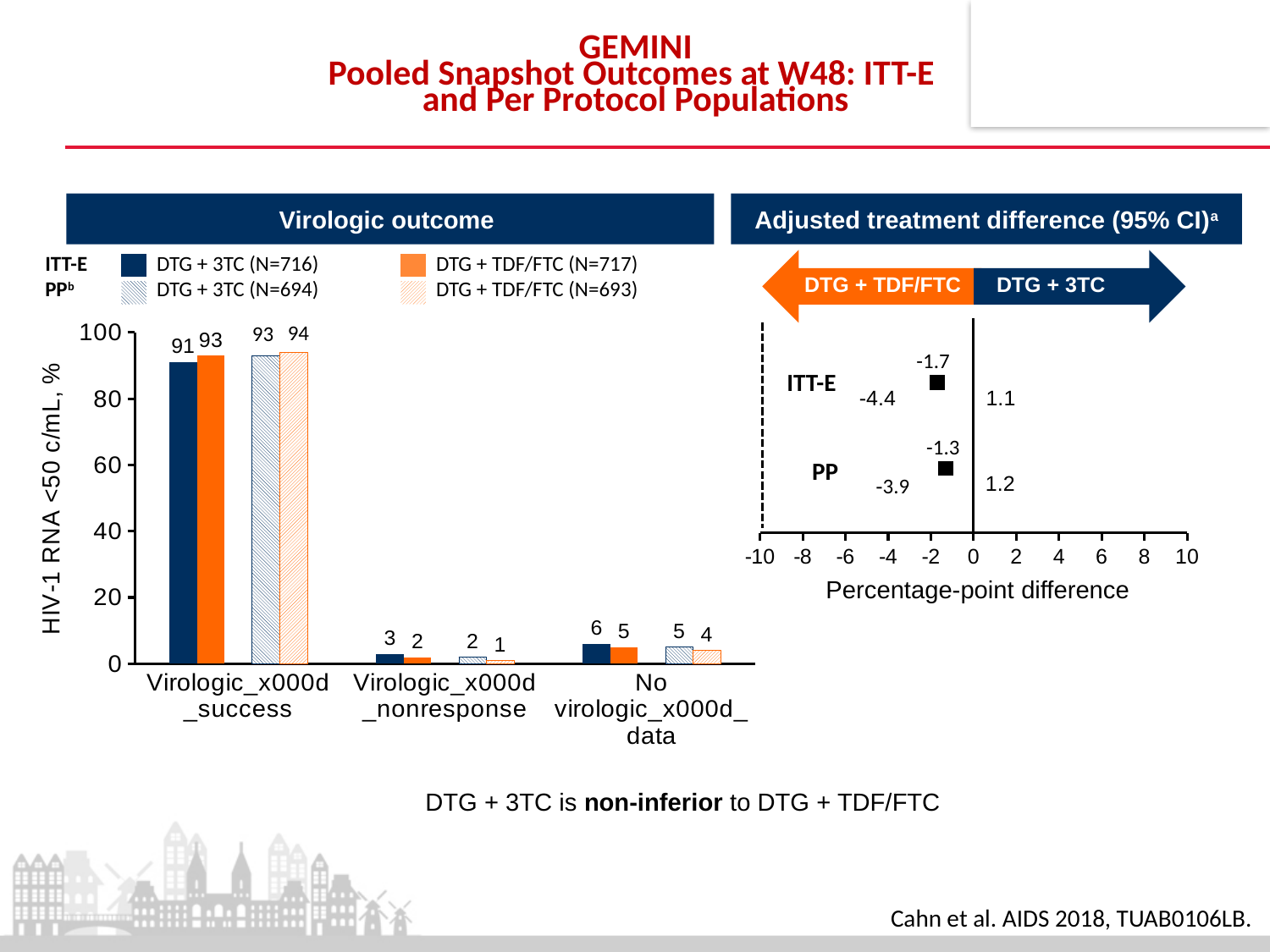
In the Adjusted treatment difference chart, what is the upper bound of the 95% CI for the ITT-E population? 1.1 What kind of chart is the Virologic outcome chart? Bar chart In the Adjusted treatment difference chart, what is the adjusted treatment difference for the ITT-E population? -1.7 In the Adjusted treatment difference chart, what is the lower bound of the 95% CI for the PP population? -3.9 In the Virologic outcome chart, is the ITT-E DTG + 3TC virologic success value greater or less than 80? greater In the Virologic outcome chart, how many series does the legend list? 4 In the Virologic outcome chart, what is the difference in virologic success between DTG + TDF/FTC and DTG + 3TC in the ITT-E population? 2 In the Virologic outcome chart, what is the virologic success rate for DTG + 3TC in the ITT-E population? 91 In the Virologic outcome chart, what is the virologic success rate for DTG + TDF/FTC in the PP population? 94 In the Virologic outcome chart, which category has the highest values across all series? Virologic success In the Virologic outcome chart, what percentage of ITT-E DTG + 3TC participants had no virologic data? 6 In the Virologic outcome chart, what is the virologic nonresponse rate for DTG + TDF/FTC in the PP population? 1